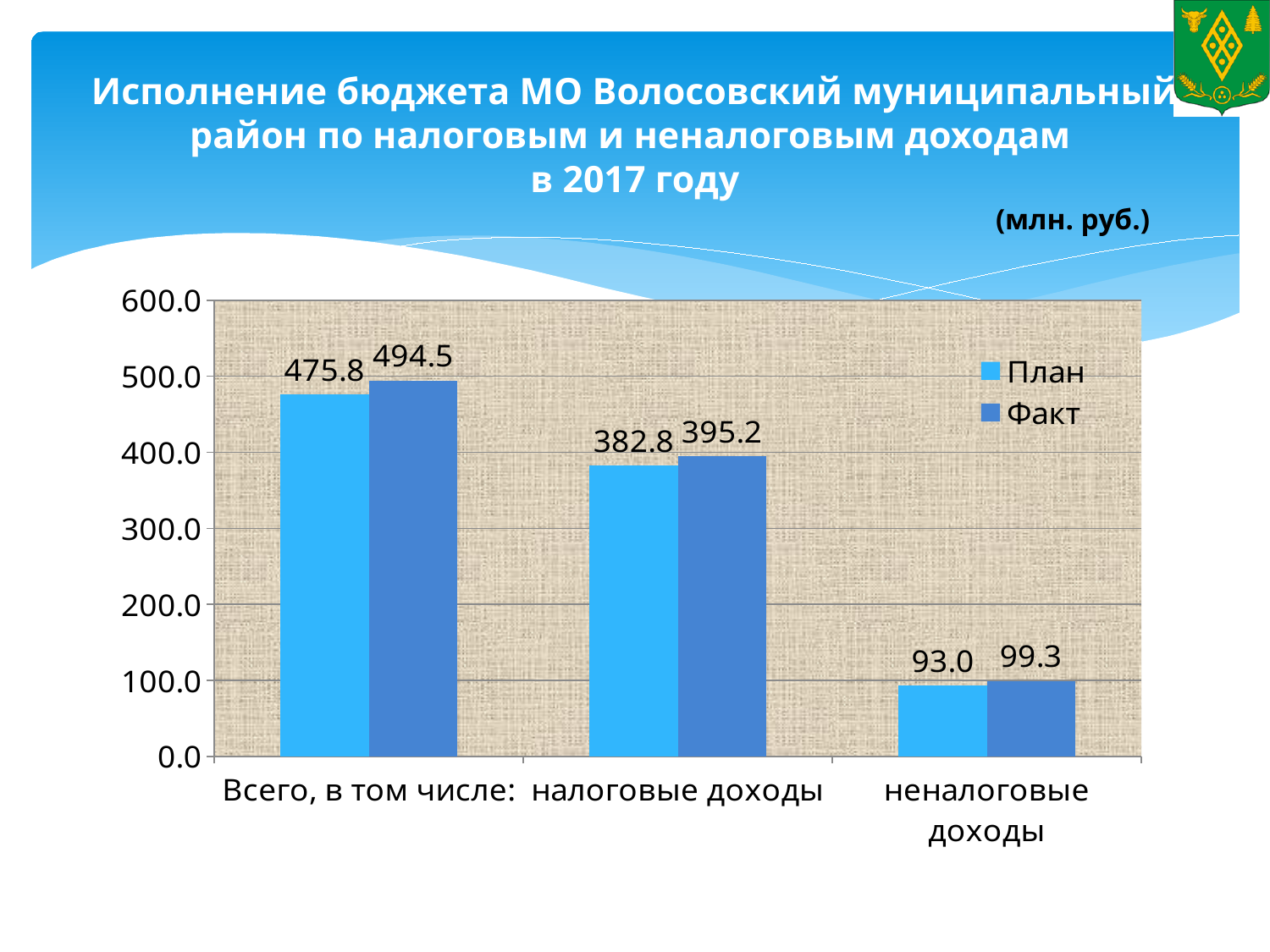
What unit is stated for the values on the slide? млн. руб. Which category has the highest Факт value? Всего, в том числе: What kind of chart is shown on the slide? bar chart What is the difference between the Факт and План values for Всего, в том числе:? 18.7 What is the Факт value for неналоговые доходы? 99.3 What is the План value for налоговые доходы? 382.8 How many series does the legend list? 2 What is the difference between the Факт and План values for налоговые доходы? 12.4 What is the Факт value for Всего, в том числе:? 494.5 Which category has the lowest План value? неналоговые доходы How many categories are shown on the x axis? 3 Which is larger for неналоговые доходы, План or Факт? Факт